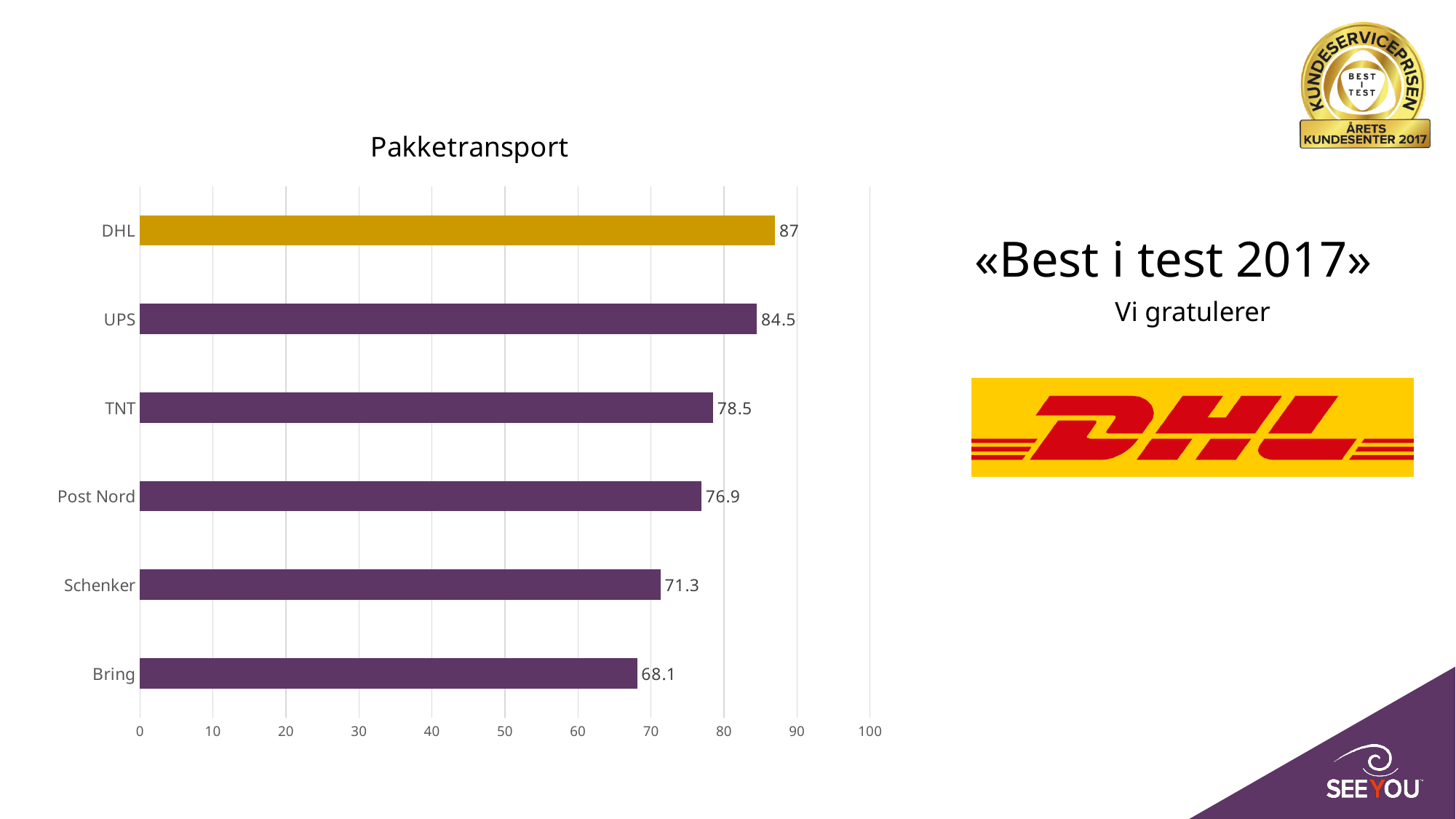
Which category has the lowest value in the Pakketransport chart? Bring What is the value for Post Nord in the Pakketransport chart? 76.9 What is the difference between the values for DHL and UPS in the Pakketransport chart? 2.5 Which has a larger value in the Pakketransport chart, TNT or Post Nord? TNT What is the difference between the values for TNT and Schenker in the Pakketransport chart? 7.2 Is the value for Schenker in the Pakketransport chart greater or less than 80? less What is the value for Bring in the Pakketransport chart? 68.1 How many categories are shown in the Pakketransport chart? 6 What kind of chart is the Pakketransport chart? bar chart What is the value for DHL in the Pakketransport chart? 87 Which category has the highest value in the Pakketransport chart? DHL Which bar in the Pakketransport chart is coloured differently from the others? DHL